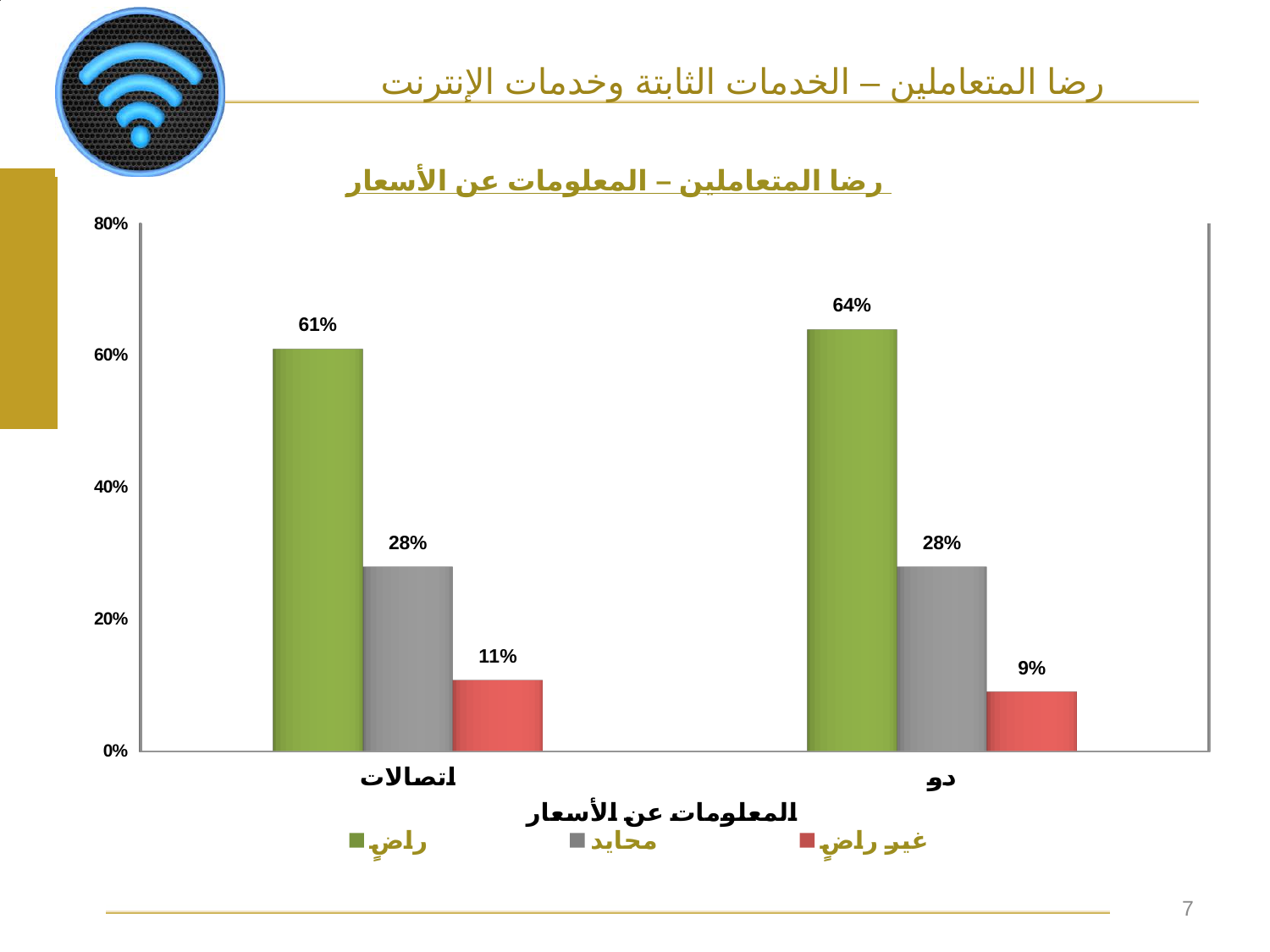
Is the value for غير راضٍ in اتصالات larger or smaller than the value for غير راضٍ in دو? larger Which category has the higher value for راضٍ? دو What is the value for غير راضٍ in the دو category? 9% What is the title of the chart? رضا المتعاملين – المعلومات عن الأسعار What is the value for راضٍ in the اتصالات category? 61% What is the value for محايد in the اتصالات category? 28% What kind of chart is shown on the slide? bar chart What is the difference between the راضٍ values for دو and اتصالات? 3% What is the difference between the غير راضٍ values for اتصالات and دو? 2% How many series does the legend list? 3 Which category has the lower value for غير راضٍ? دو How many categories are shown on the x axis? 2